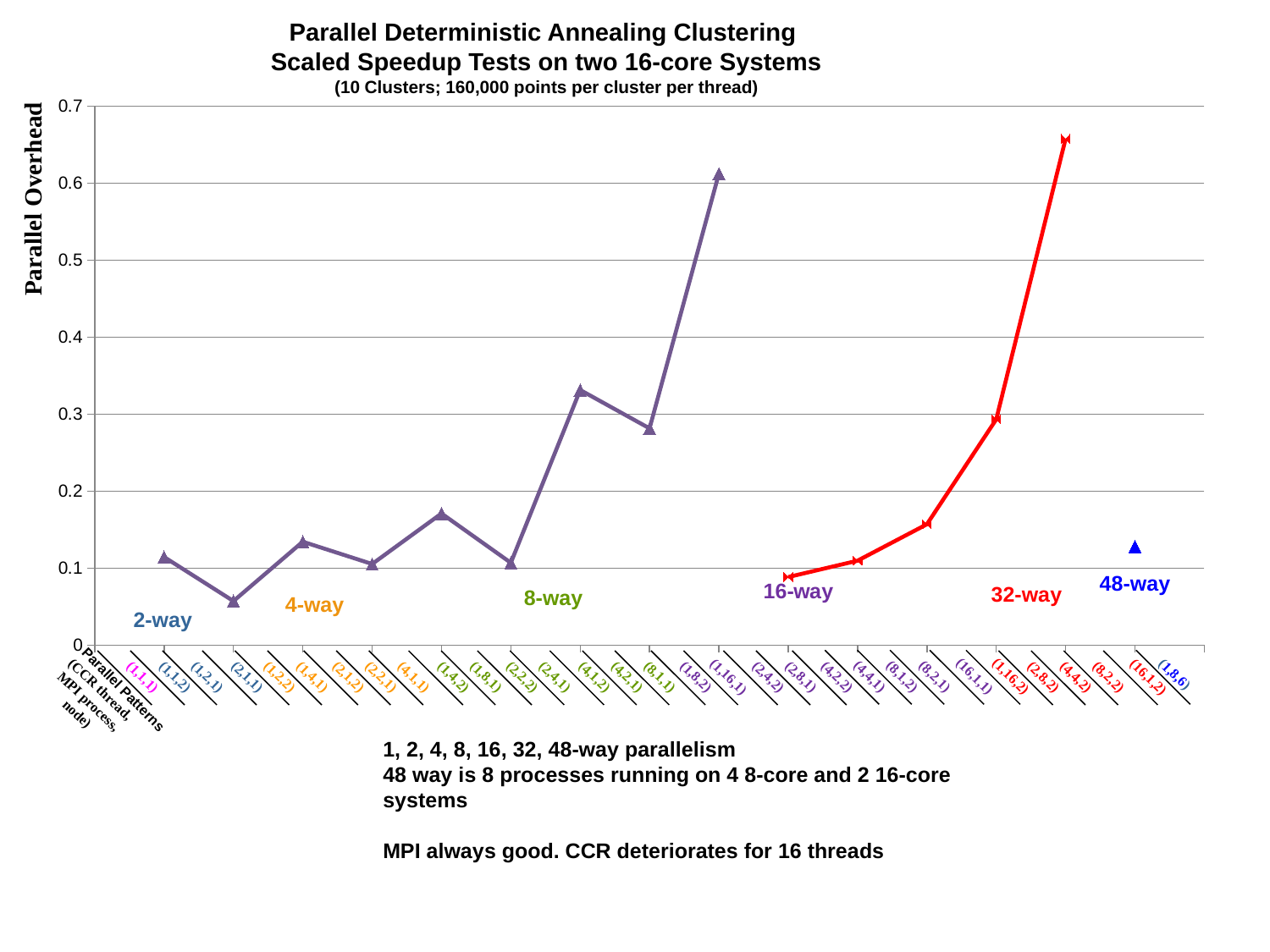
What is the label on the vertical axis of the chart? Parallel Overhead How many data points are plotted on the purple line? 9 What is the title of the chart? Parallel Deterministic Annealing Clustering Scaled Speedup Tests on two 16-core Systems How many data points are plotted on the red line? 5 Is the highest point of the purple line greater or less than 0.5? greater Is the value of the single 48-way point greater or less than 0.1? greater Does the red 32-way line rise or fall from left to right? rises Which reaches a higher parallel overhead: the peak of the red 32-way line or the peak of the purple line? the red 32-way line Is the first (leftmost) point of the red 16-way/32-way line greater or less than 0.1? less What kind of chart is shown on the slide? line chart